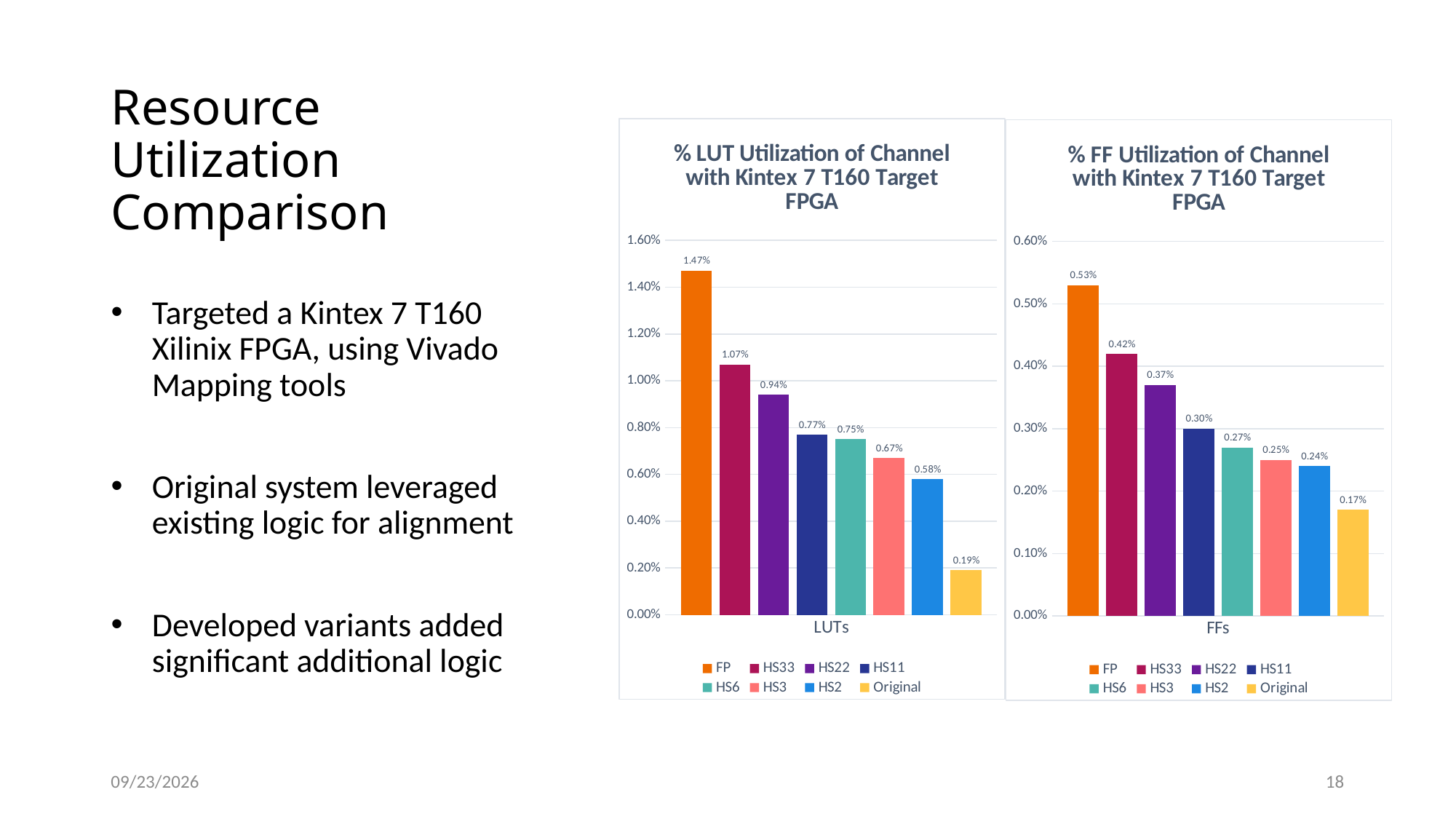
In the % LUT Utilization chart, which is larger, the value for HS22 or the value for HS2? HS22 In the % LUT Utilization chart, which series has the lowest value? Original In the % FF Utilization chart, is the value for HS11 greater or less than 0.40%? less What is the x-axis category label shown on the % FF Utilization chart? FFs In the % FF Utilization chart, which series has the highest value? FP How many series does the legend of the % FF Utilization chart list? 8 In the % FF Utilization chart, what is the difference between the HS33 value and the Original value? 0.25% What kind of chart is the % LUT Utilization chart? bar chart In the % LUT Utilization chart, what is the difference between the FP value and the HS33 value? 0.40% In the % LUT Utilization chart, what is the value for Original? 0.19% In the % LUT Utilization chart, what is the value for FP? 1.47% In the % FF Utilization chart, what is the value for HS22? 0.37%